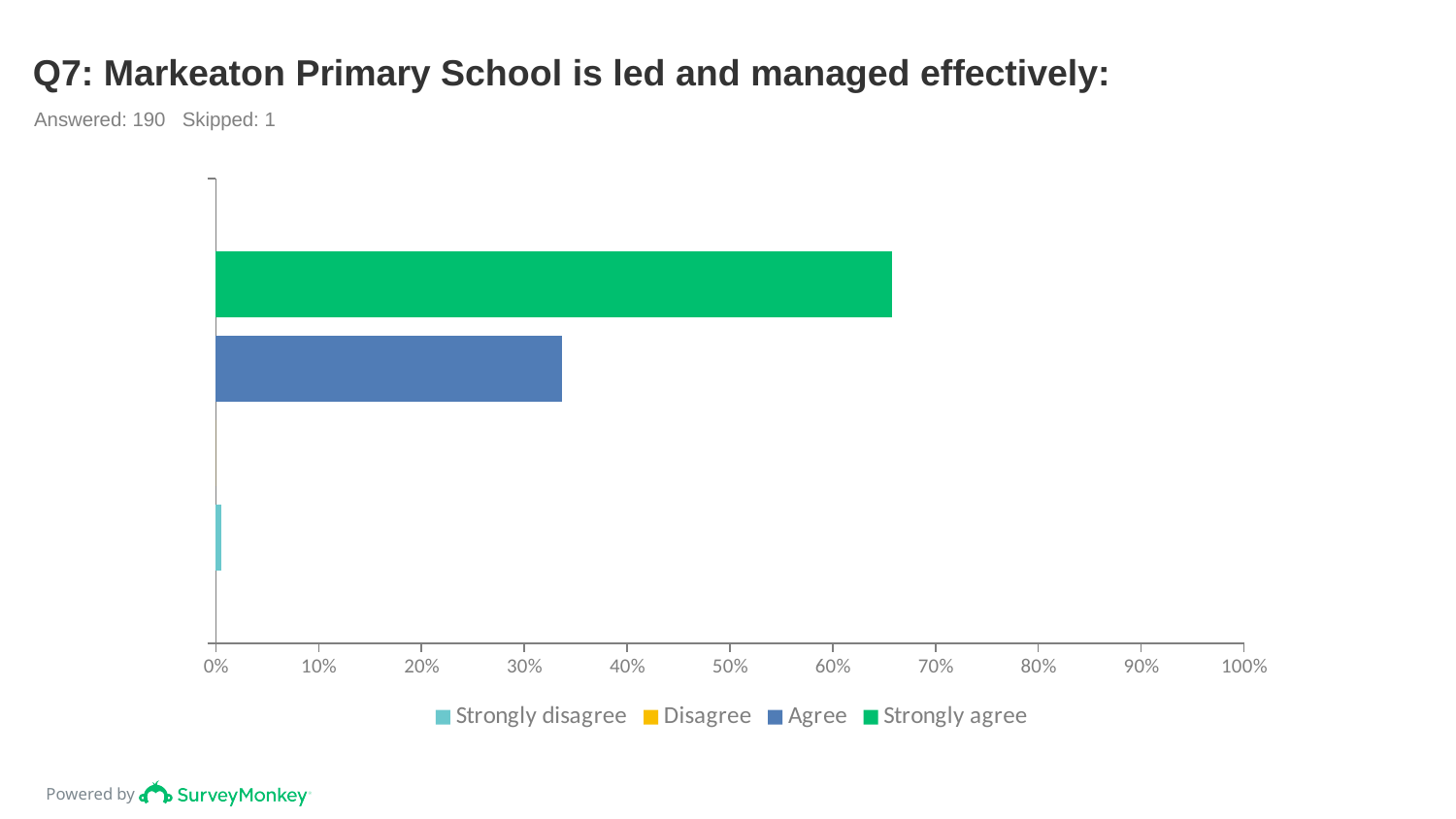
Is the value for Strongly agree greater or less than 70%? less What colour is the bar for Strongly agree? green Which response option has the highest value? Strongly agree What kind of chart is shown on the slide? bar chart Which is larger, the value for Agree or the value for Strongly disagree? Agree Is the value for Agree greater or less than 40%? less Which is larger, the value for Strongly agree or the value for Agree? Strongly agree Is the value for Agree greater or less than 30%? greater What is the title of the chart? Q7: Markeaton Primary School is led and managed effectively: How many series does the legend list? 4